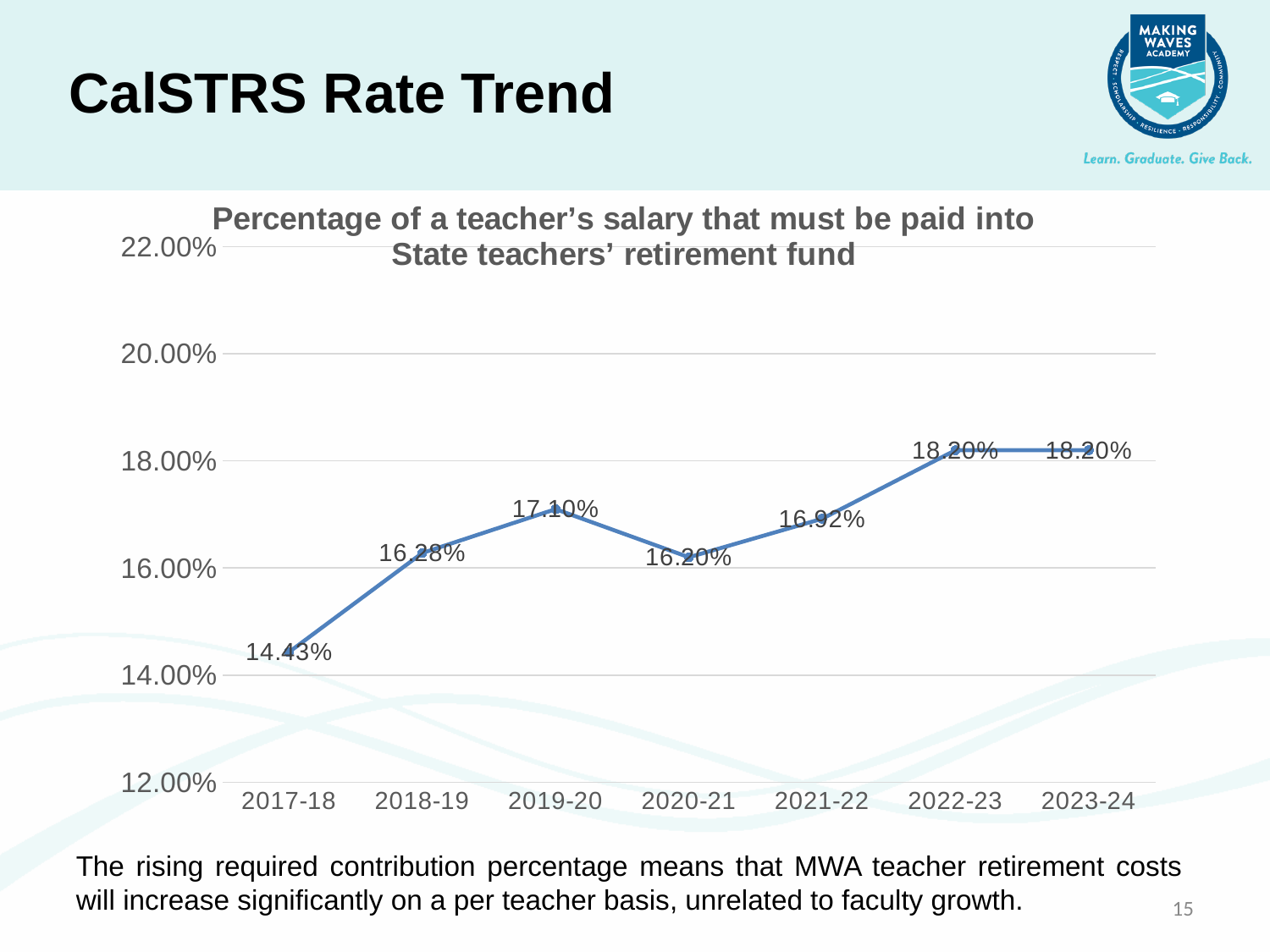
What is the value for 2019-20? 17.10% What is the value for 2017-18? 14.43% Is the value for 2018-19 greater or less than 16.00%? greater Does the value rise or fall from 2019-20 to 2020-21? Fall What type of chart is shown on the slide? Line chart Which year has the lowest value? 2017-18 What is the difference between the values for 2022-23 and 2017-18? 3.77% Which is larger, the value for 2019-20 or the value for 2020-21? 2019-20 What is the highest value shown on the chart? 18.20% How many years are plotted on the x axis? 7 What is the title of the chart? Percentage of a teacher's salary that must be paid into State teachers' retirement fund What is the value for 2021-22? 16.92%